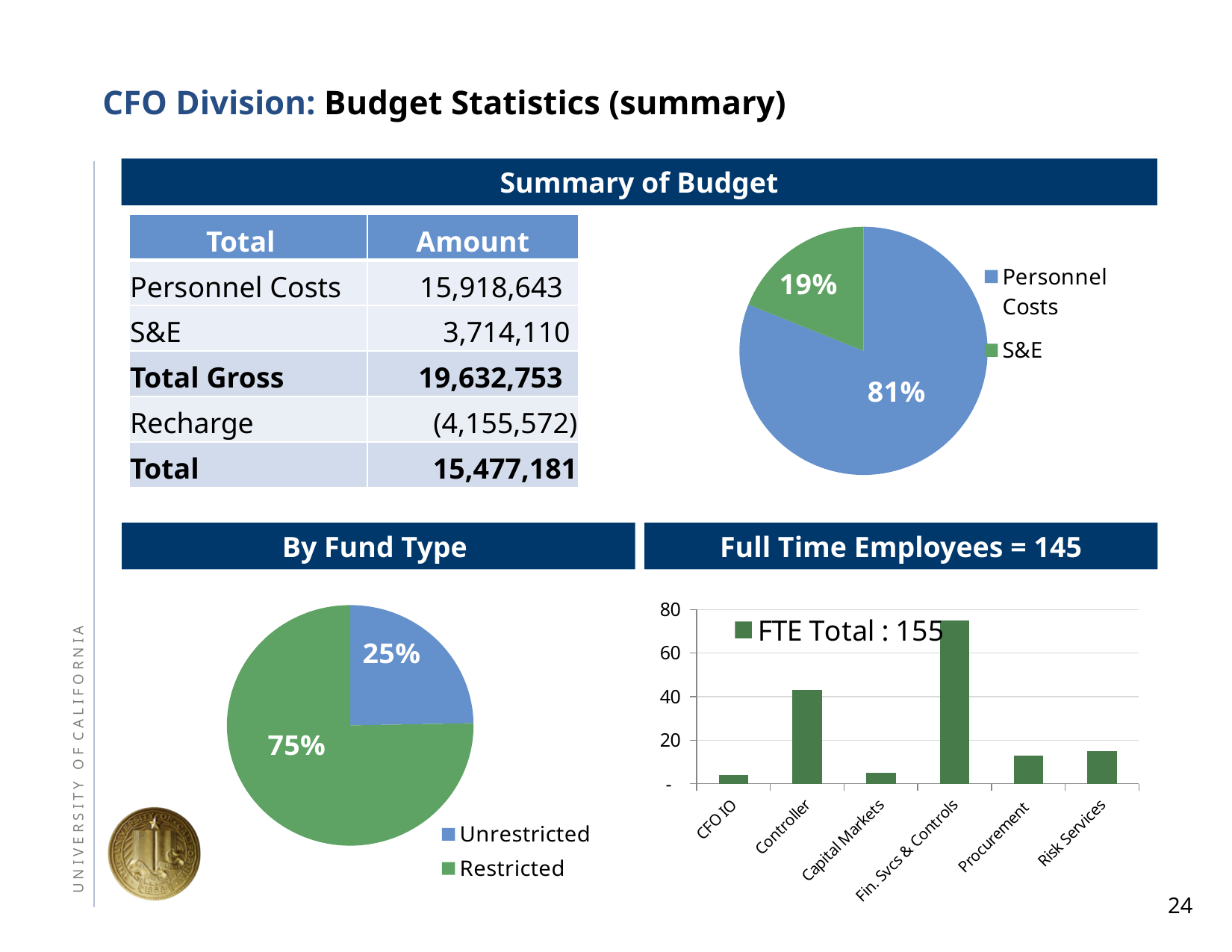
In the Full Time Employees bar chart, is the value for Procurement greater or less than 20? less What kind of chart is shown under the Full Time Employees = 145 heading? bar chart In the By Fund Type pie chart, what share is Restricted? 75% In the Full Time Employees bar chart, what does the legend entry say? FTE Total : 155 In the Full Time Employees bar chart, is the value for Controller greater or less than 40? greater In the Summary of Budget pie chart, what share does S&E have? 19% In the Summary of Budget pie chart, which slice is larger, Personnel Costs or S&E? Personnel Costs In the Summary of Budget pie chart, what share does Personnel Costs have? 81% In the Full Time Employees bar chart, which category has the highest value? Fin. Svcs & Controls In the Full Time Employees bar chart, how many categories are shown on the x axis? 6 In the By Fund Type pie chart, what is the difference in percentage points between the Restricted and Unrestricted slices? 50